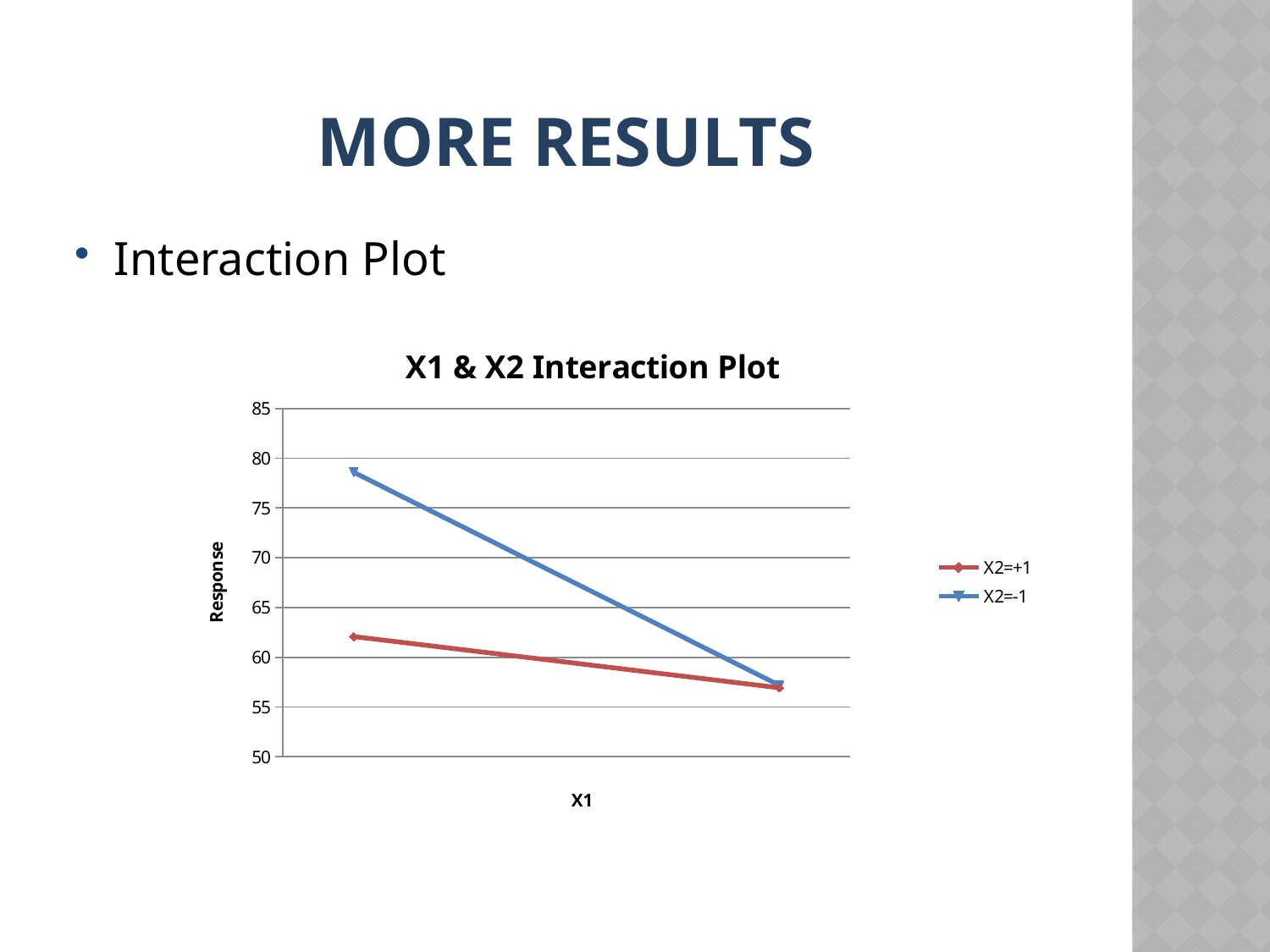
Does the X2=-1 line rise or fall as X1 increases along the x axis? fall What is the title of the chart? X1 & X2 Interaction Plot What kind of chart is shown on the slide? line chart How many data points does each line have? 2 At the left end of the x axis, which series has the higher Response, X2=+1 or X2=-1? X2=-1 Is the Response for X2=-1 at the left end of the x axis greater or less than 75? greater What are the two series named in the legend? X2=+1 and X2=-1 Is the Response for X2=-1 at the right end of the x axis greater or less than 60? less Which series shows the steeper decline across the x axis, X2=+1 or X2=-1? X2=-1 Is the Response for X2=+1 at the left end of the x axis greater or less than 60? greater How many series does the legend list? 2 Does the X2=+1 line rise or fall as X1 increases along the x axis? fall